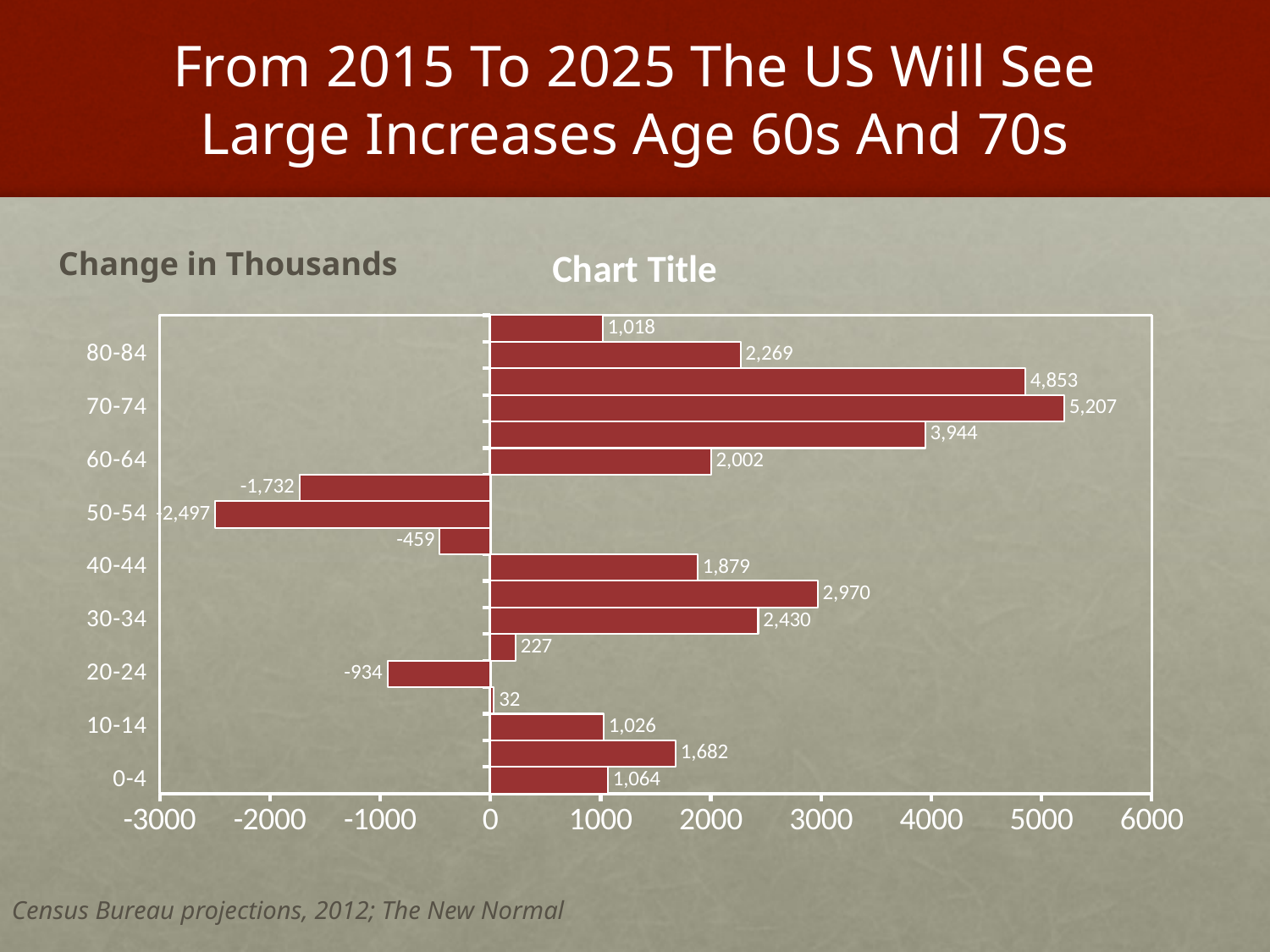
Which labeled age group has the lowest value? 50-54 Is the value for 60-64 greater or less than 1000? greater What is the value for the 20-24 age group? -934 What is the difference between the values for 70-74 and 60-64? 3,205 What kind of chart is shown on the slide? Bar chart What is the value for the 0-4 age group? 1,064 Which is larger, the value for 40-44 or the value for 80-84? 80-84 What is the value for the 30-34 age group? 2,430 What is the value for the 70-74 age group? 5,207 What is the value for the 50-54 age group? -2,497 How many bars are plotted in the chart? 18 Which labeled age group has the highest value? 70-74